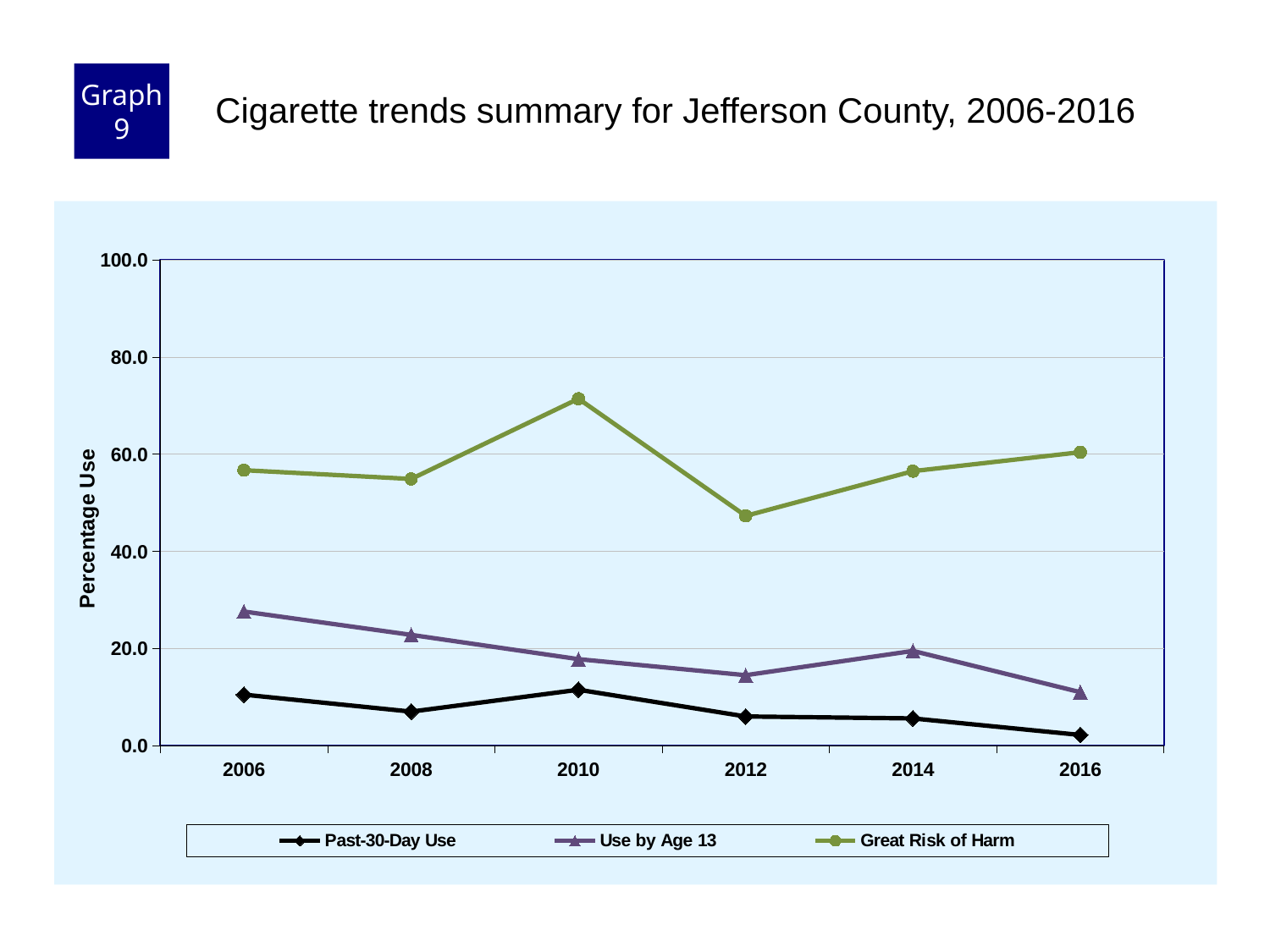
Is the Great Risk of Harm value for 2010 greater or less than 60.0? greater How many series does the legend list? 3 How many years are plotted along the x axis? 6 Is the Great Risk of Harm value for 2012 greater or less than 60.0? less In which year is the Past-30-Day Use value lowest? 2016 Is the Use by Age 13 value for 2006 greater or less than 20.0? greater What is the title of the y axis? Percentage Use In which year is the Great Risk of Harm value highest? 2010 What type of chart is shown on the slide? line chart In which year is the Great Risk of Harm value lowest? 2012 In which year is the Use by Age 13 value highest? 2006 In 2010, which is larger: Use by Age 13 or Past-30-Day Use? Use by Age 13